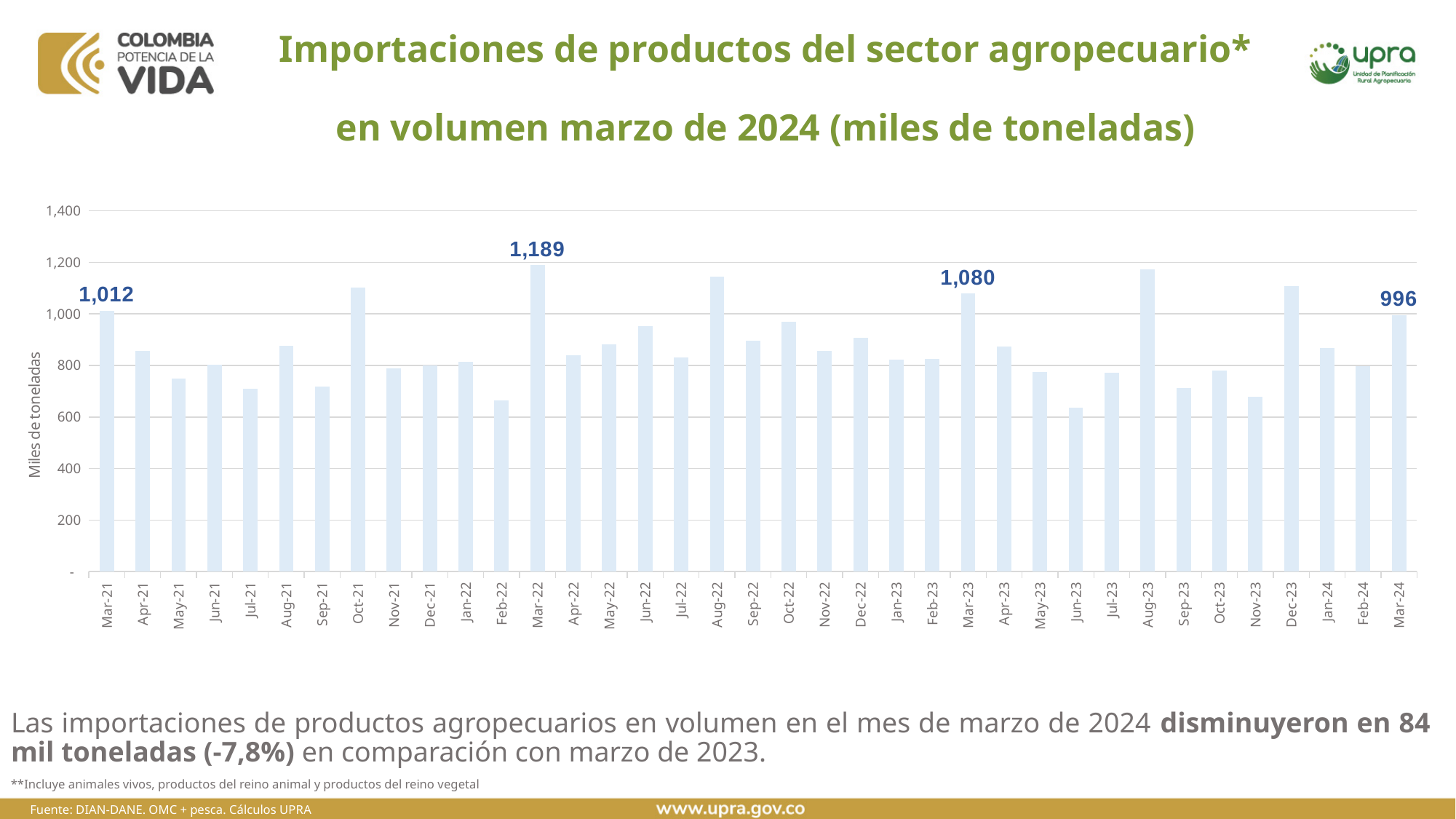
What is the difference between the values for Mar-23 and Mar-24? 84 What kind of chart is shown on the slide? bar chart What is the value for Mar-22? 1,189 How many months (bars) are shown on the chart? 37 What is the value for Mar-23? 1,080 What is the value for Mar-24? 996 What is the label of the vertical axis? Miles de toneladas What is the value for Mar-21? 1,012 Is the value for Oct-21 greater or less than 1,000? greater What is the difference between the values for Mar-22 and Mar-21? 177 Is the value for Feb-22 greater or less than 800? less Which is larger, the value for Mar-22 or the value for Mar-23? Mar-22